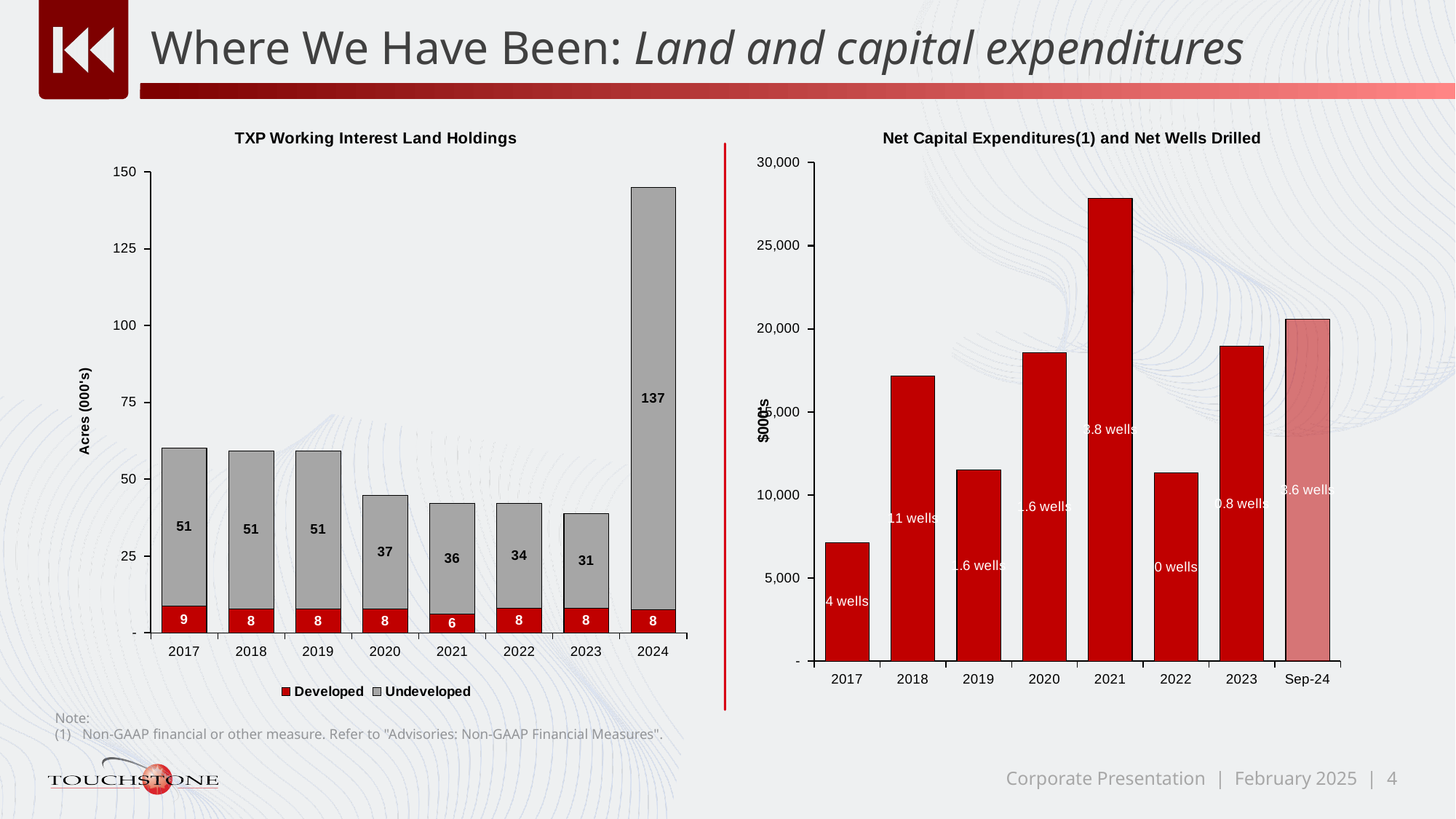
How many periods are shown on the x axis of the Net Capital Expenditures(1) and Net Wells Drilled chart? 8 In the TXP Working Interest Land Holdings chart, what is the Undeveloped value for 2024? 137 In the Net Capital Expenditures(1) and Net Wells Drilled chart, is the value for 2021 greater or less than 25,000? greater In the Net Capital Expenditures(1) and Net Wells Drilled chart, which period has the lowest bar? 2017 In the TXP Working Interest Land Holdings chart, which year has the lowest Developed value? 2021 What kind of chart is the Net Capital Expenditures(1) and Net Wells Drilled chart? bar chart In the Net Capital Expenditures(1) and Net Wells Drilled chart, which period has the highest bar? 2021 How many series does the legend of the TXP Working Interest Land Holdings chart list? 2 In the TXP Working Interest Land Holdings chart, what is the difference between the Undeveloped values for 2017 and 2023? 20 In the TXP Working Interest Land Holdings chart, which year has the highest Undeveloped value? 2024 In the TXP Working Interest Land Holdings chart, what is the Developed value for 2021? 6 In the TXP Working Interest Land Holdings chart, what is the total of the stacked bar for 2024? 145